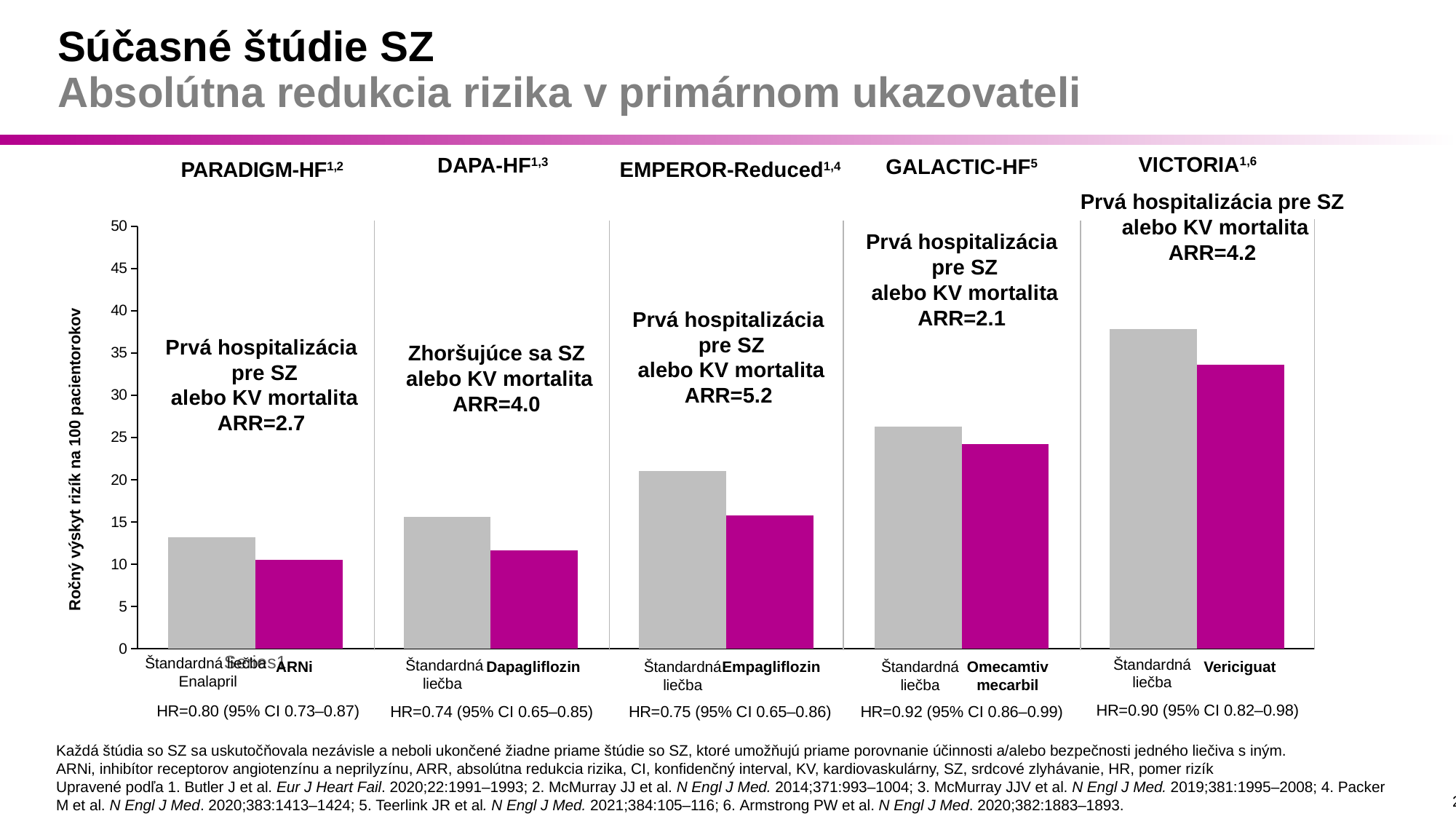
Which bar in the chart is the lowest? ARNi (PARADIGM-HF) Is the value for Štandardná liečba in GALACTIC-HF greater or less than 25? greater How many trials (groups of bars) are shown in the chart? 5 What ARR is printed for EMPEROR-Reduced? ARR=5.2 Is the value for Vericiguat greater or less than 30? greater What is the label of the vertical axis? Ročný výskyt rizík na 100 pacientorokov What hazard ratio is printed under the DAPA-HF bars? HR=0.74 (95% CI 0.65–0.85) Is the value for Štandardná liečba Enalapril in PARADIGM-HF greater or less than 15? less What kind of chart is shown on the slide? Bar chart Which trial has the tallest standard-care (Štandardná liečba) bar? VICTORIA In DAPA-HF, which bar is taller: Štandardná liečba or Dapagliflozin? Štandardná liečba